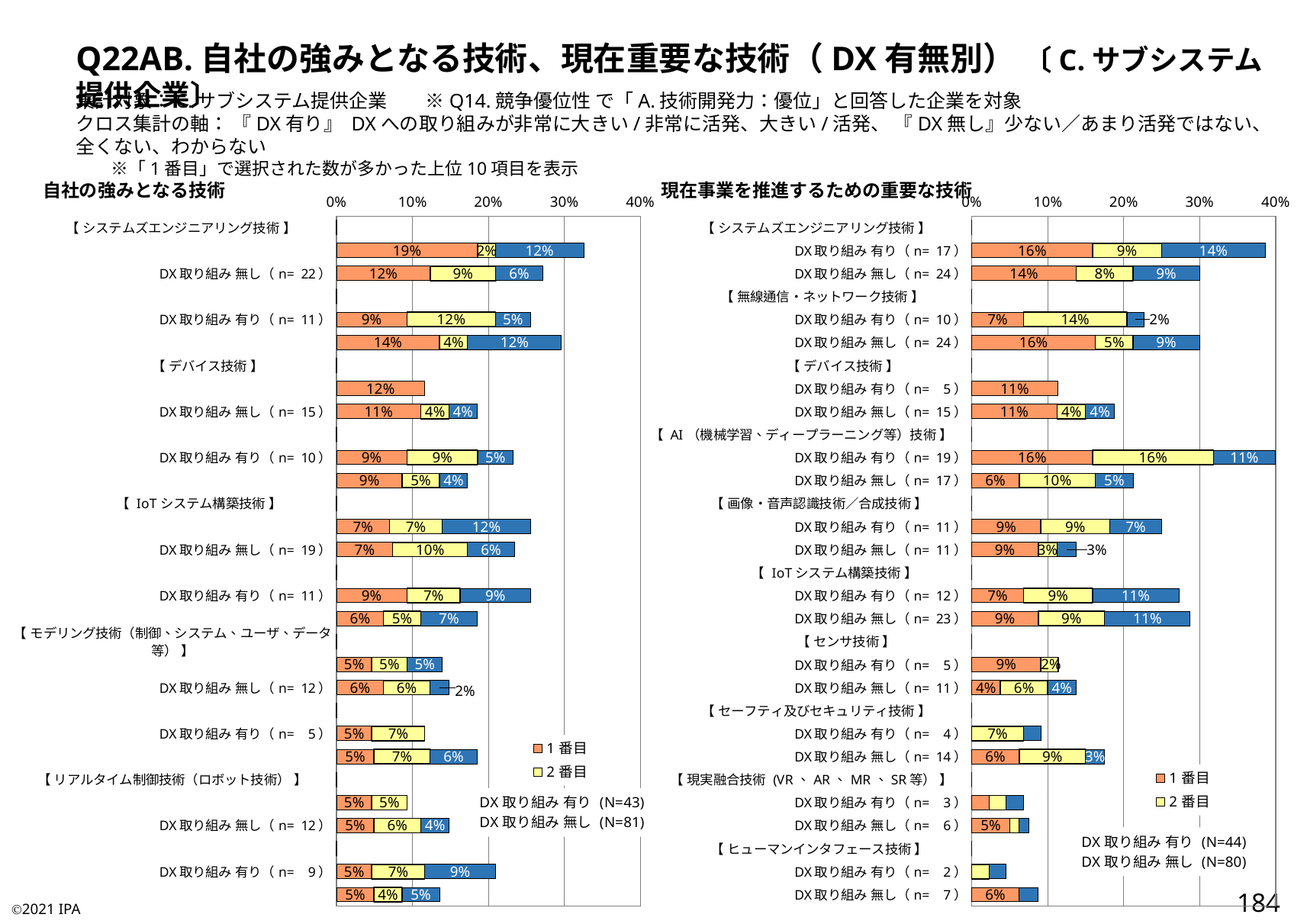
In the right-hand chart (現在事業を推進するための重要な技術), is the total bar length for DX取り組み無し (n=11) under センサ技術 greater or less than 20%? less In the right-hand chart (現在事業を推進するための重要な技術), what is the difference between the 1番目 values of DX取り組み有り (n=17) and DX取り組み無し (n=24) under システムズエンジニアリング技術? 2% According to the note beside the legend of the right-hand chart (現在事業を推進するための重要な技術), what is the N for DX取り組み無し? N=80 In the right-hand chart (現在事業を推進するための重要な技術), what is the 1番目 value for DX取り組み無し (n=7) under ヒューマンインタフェース技術? 6% In the right-hand chart (現在事業を推進するための重要な技術), which has the larger 1番目 value under AI（機械学習、ディープラーニング等）技術: DX取り組み有り (n=19) or DX取り組み無し (n=17)? DX取り組み有り (n=19) In the right-hand chart (現在事業を推進するための重要な技術), what is the 2番目 value for DX取り組み有り (n=10) under 無線通信・ネットワーク技術? 14% In the right-hand chart (現在事業を推進するための重要な技術), what is the 1番目 value for DX取り組み有り (n=19) under AI（機械学習、ディープラーニング等）技術? 16% In the right-hand chart (現在事業を推進するための重要な技術), what is the 1番目 value for DX取り組み無し (n=24) under システムズエンジニアリング技術? 14% What kind of chart is the right-hand chart titled 現在事業を推進するための重要な技術? Stacked bar chart How many series does the legend of the right-hand chart (現在事業を推進するための重要な技術) list? 2 In the right-hand chart (現在事業を推進するための重要な技術), is the total bar length for DX取り組み有り (n=17) under システムズエンジニアリング技術 greater or less than 30%? greater According to the note beside the legend of the left-hand chart (自社の強みとなる技術), what is the N for DX取り組み有り? N=43